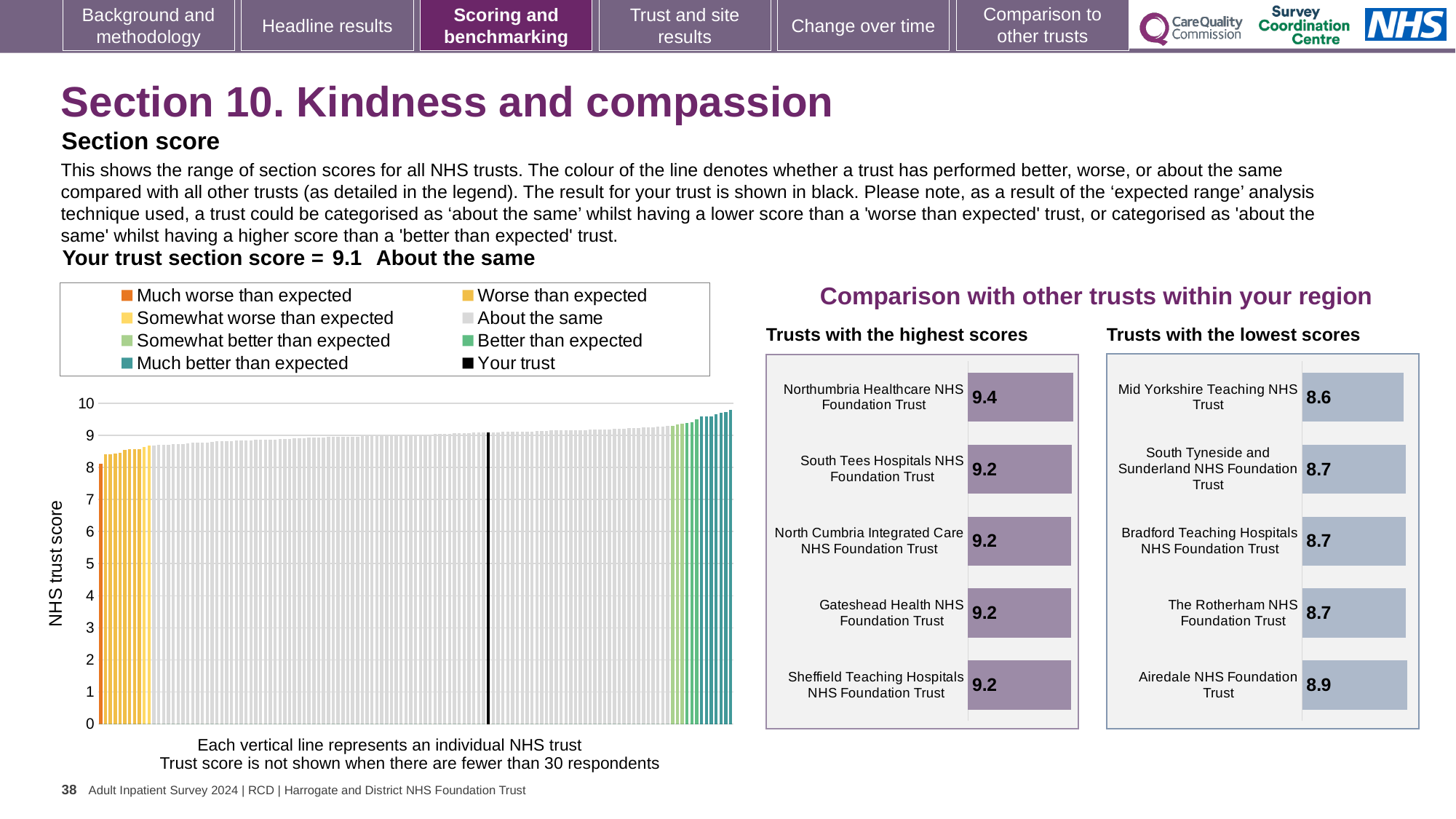
In the 'Trusts with the lowest scores' chart, what is the score for Mid Yorkshire Teaching NHS Trust? 8.6 In the 'Trusts with the highest scores' chart, what is the difference between the scores of Northumbria Healthcare NHS Foundation Trust and Sheffield Teaching Hospitals NHS Foundation Trust? 0.2 In the 'Trusts with the lowest scores' chart, what is the difference between the scores of Airedale NHS Foundation Trust and Mid Yorkshire Teaching NHS Trust? 0.3 What kind of chart is the NHS trust score chart on the left of the slide? Bar chart In the 'Trusts with the lowest scores' chart, which trust has the highest score? Airedale NHS Foundation Trust In the 'Trusts with the lowest scores' chart, which has the larger score: Bradford Teaching Hospitals NHS Foundation Trust or Airedale NHS Foundation Trust? Airedale NHS Foundation Trust In the 'Trusts with the lowest scores' chart, which trust has the lowest score? Mid Yorkshire Teaching NHS Trust In the NHS trust score chart on the left, how many entries does the legend list? 8 In the 'Trusts with the highest scores' chart, what is the score for Northumbria Healthcare NHS Foundation Trust? 9.4 In the 'Trusts with the highest scores' chart, which trust has the highest score? Northumbria Healthcare NHS Foundation Trust In the NHS trust score chart on the left, is the value of the lowest bar greater or less than 5? greater In the 'Trusts with the highest scores' chart, how many trusts are listed? 5